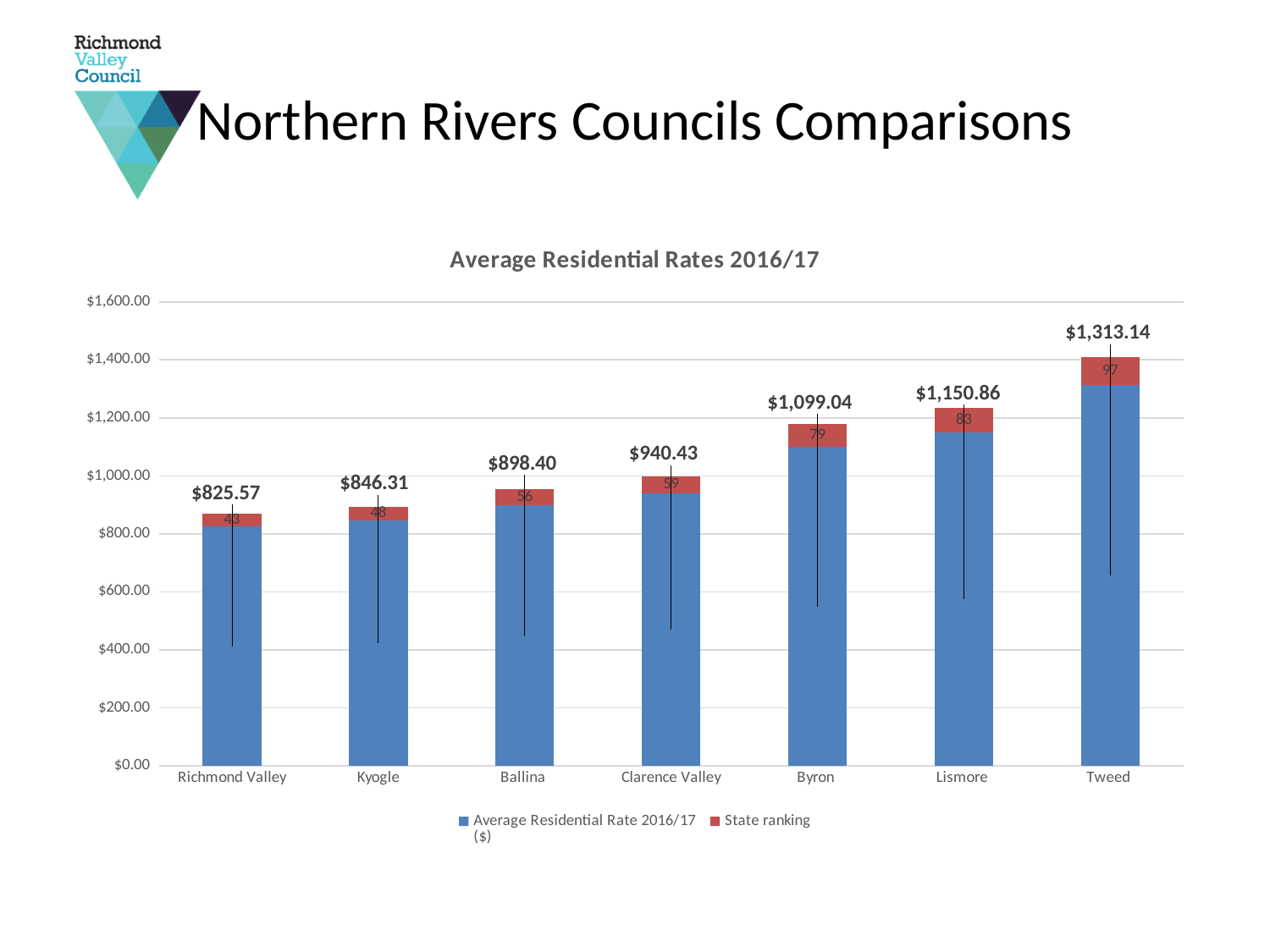
Which council has the highest Average Residential Rate 2016/17? Tweed Which council has the lowest Average Residential Rate 2016/17? Richmond Valley What is the State ranking value shown for Ballina? 56 Do the Average Residential Rate 2016/17 values rise or fall from Richmond Valley to Tweed along the x axis? Rise What is the difference between the Average Residential Rate 2016/17 for Tweed and for Richmond Valley? $487.57 What is the Average Residential Rate 2016/17 for Richmond Valley? $825.57 What kind of chart is shown on the slide? Stacked bar chart How many councils are shown on the x axis of the chart? 7 How many series does the chart legend list? 2 What is the Average Residential Rate 2016/17 for Byron? $1,099.04 Which has a higher Average Residential Rate 2016/17, Lismore or Byron? Lismore What is the State ranking value shown for Tweed? 97